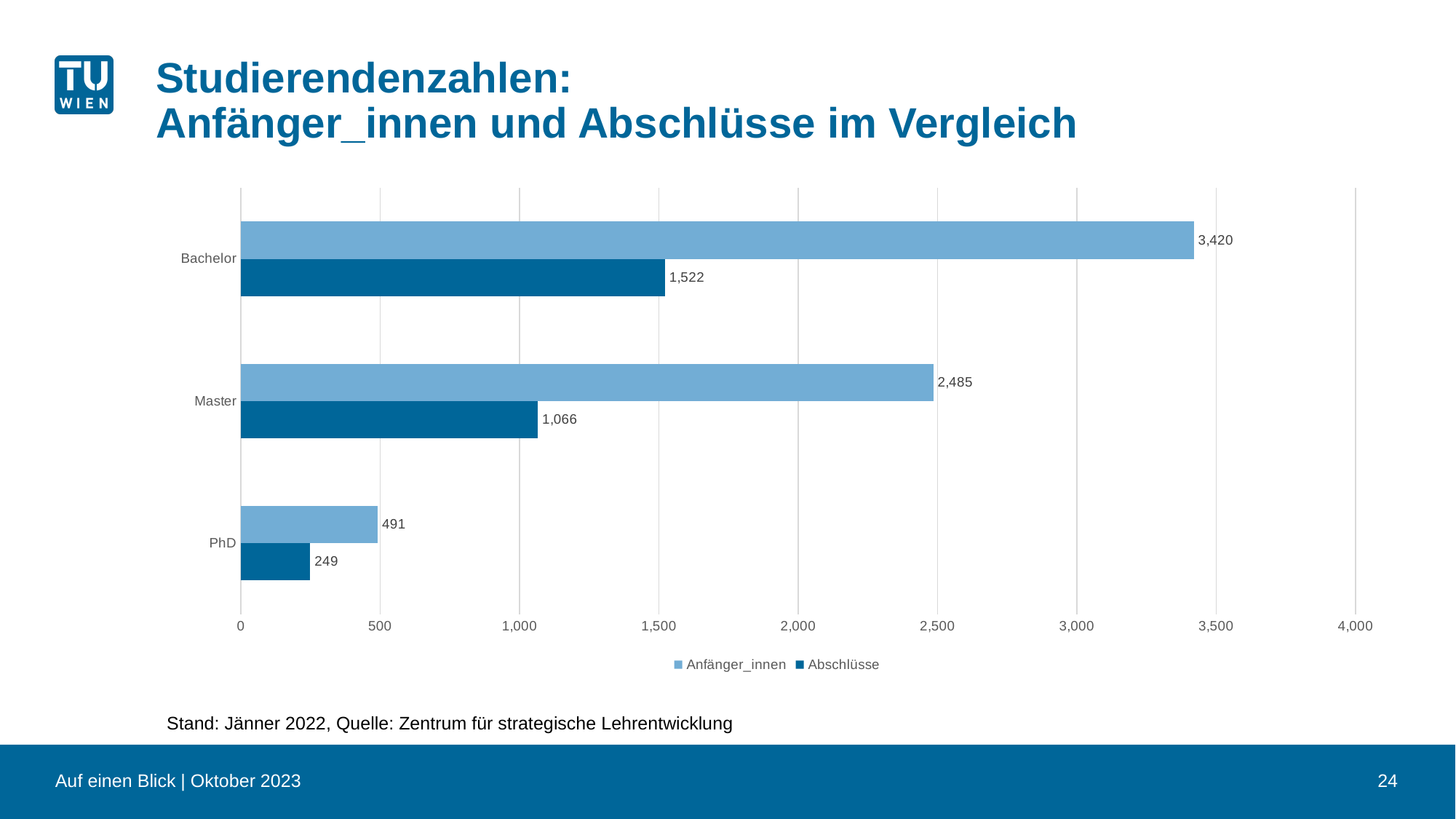
What is the difference between Anfänger_innen and Abschlüsse for Bachelor? 1,898 Which series is shown in the darker blue colour? Abschlüsse What is the difference between the Anfänger_innen values for Master and PhD? 1,994 What is the Anfänger_innen value for Bachelor? 3,420 How many series does the legend list? 2 Which is larger: Abschlüsse for Bachelor or Anfänger_innen for Master? Anfänger_innen for Master How many categories are shown on the y axis? 3 What is the Abschlüsse value for Master? 1,066 Which category has the highest Anfänger_innen value? Bachelor What kind of chart is shown on the slide? Bar chart What is the Abschlüsse value for PhD? 249 Which category has the lowest Abschlüsse value? PhD